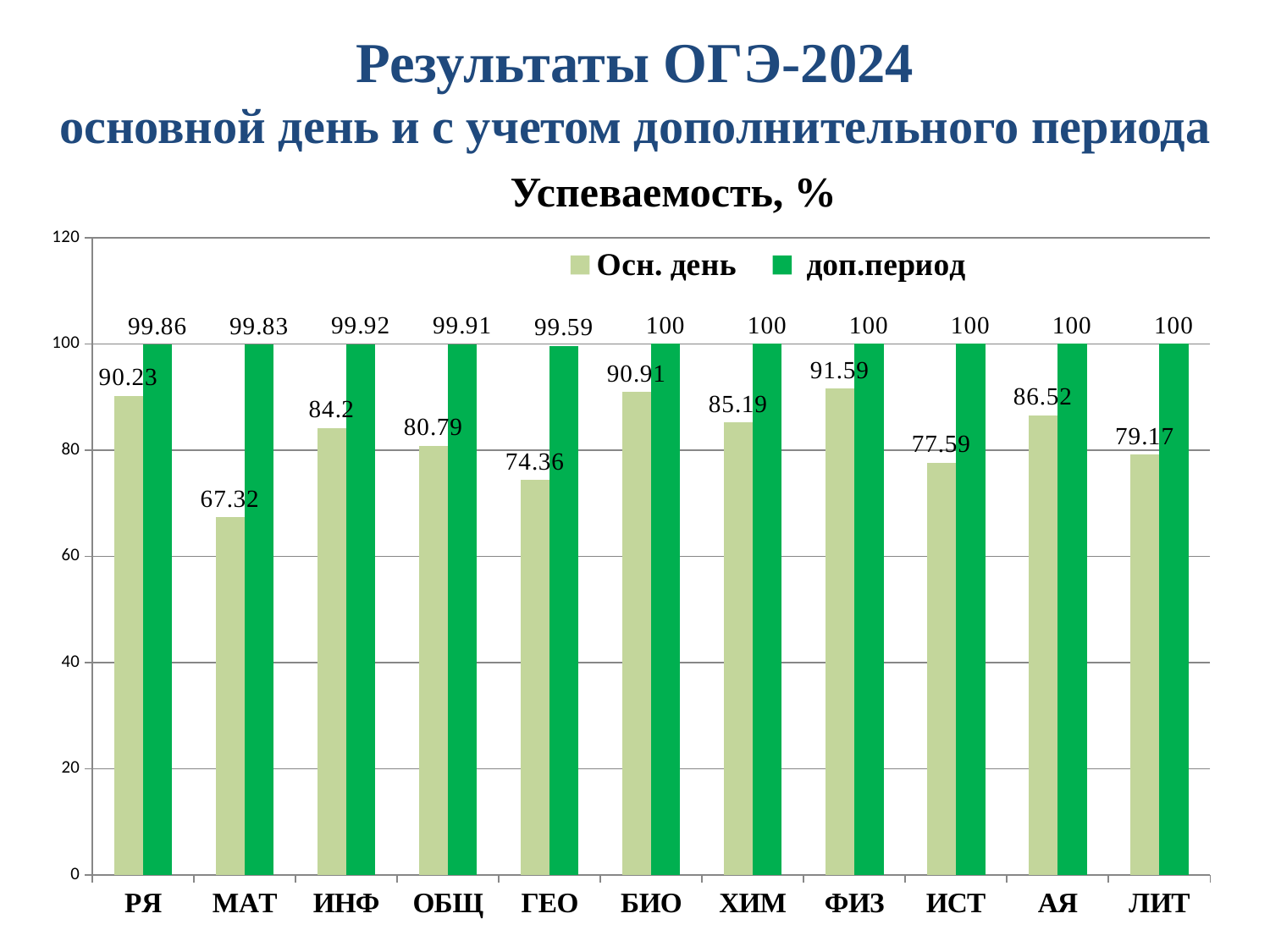
Which category has the lowest value in the Осн. день series? МАТ Which is larger: the Осн. день value for БИО or for ХИМ? БИО What kind of chart is shown on the slide? Bar chart What is the title of the chart? Успеваемость, % What is the value for ГЕО in the доп.период series? 99.59 What is the difference between the доп.период and Осн. день values for МАТ? 32.51 Which category has the highest value in the Осн. день series? ФИЗ How many series does the legend list? 2 How many categories are shown on the x axis? 11 What is the value for ФИЗ in the Осн. день series? 91.59 Which category has the lowest value in the доп.период series? ГЕО What is the value for МАТ in the Осн. день series? 67.32